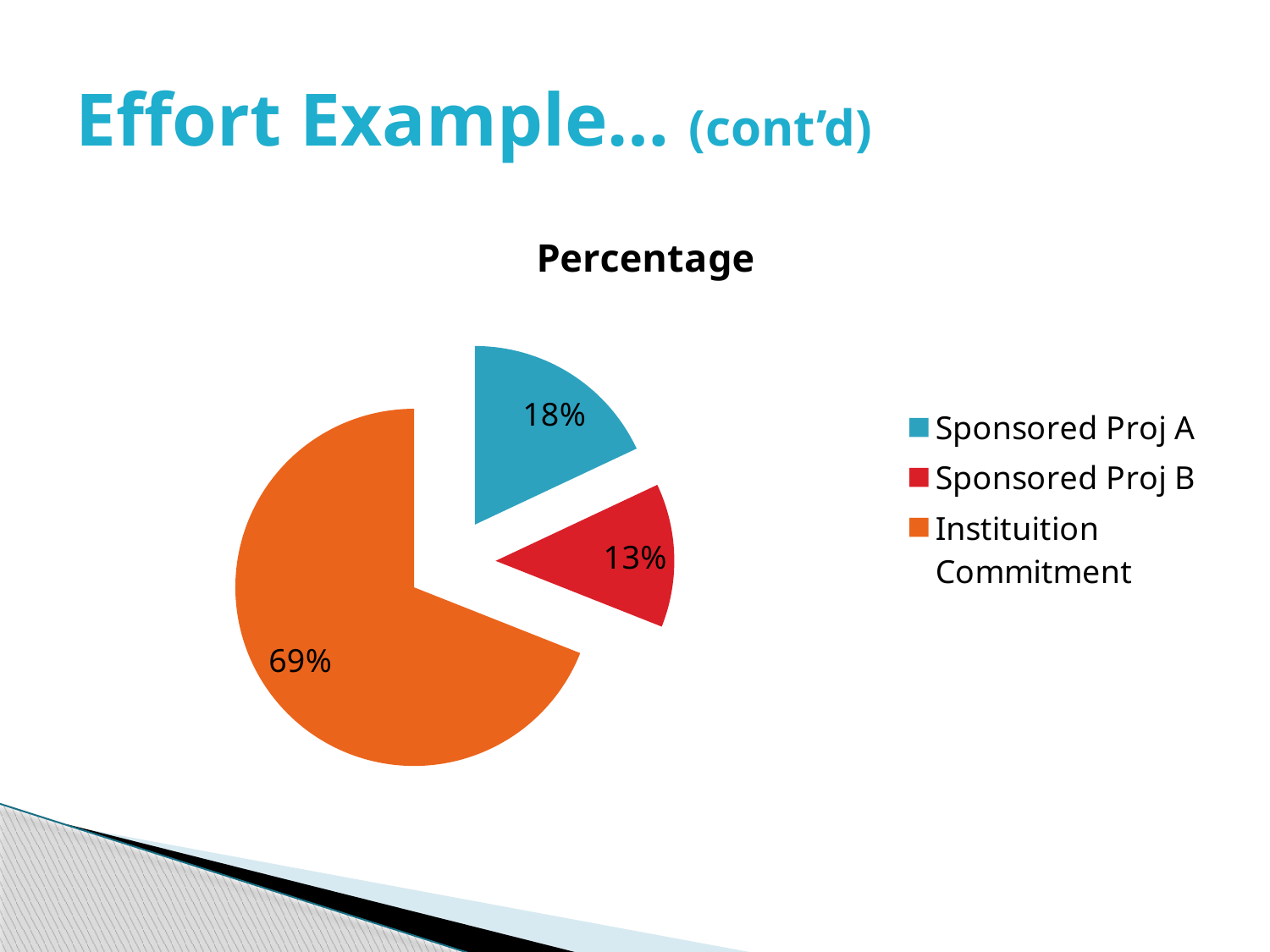
How many slices does the pie chart have? 3 Which category has the smallest share of the pie? Sponsored Proj B What colour is the slice for Instituition Commitment? Orange Which is larger, the share for Sponsored Proj A or Sponsored Proj B? Sponsored Proj A What percentage is shown for Sponsored Proj B? 13% What is the title of the chart? Percentage What percentage is shown for Instituition Commitment? 69% What is the difference between the shares of Sponsored Proj A and Sponsored Proj B? 5% What kind of chart is shown on the slide? Pie chart How many entries does the legend list? 3 Which category has the largest share of the pie? Instituition Commitment What percentage is shown for Sponsored Proj A? 18%